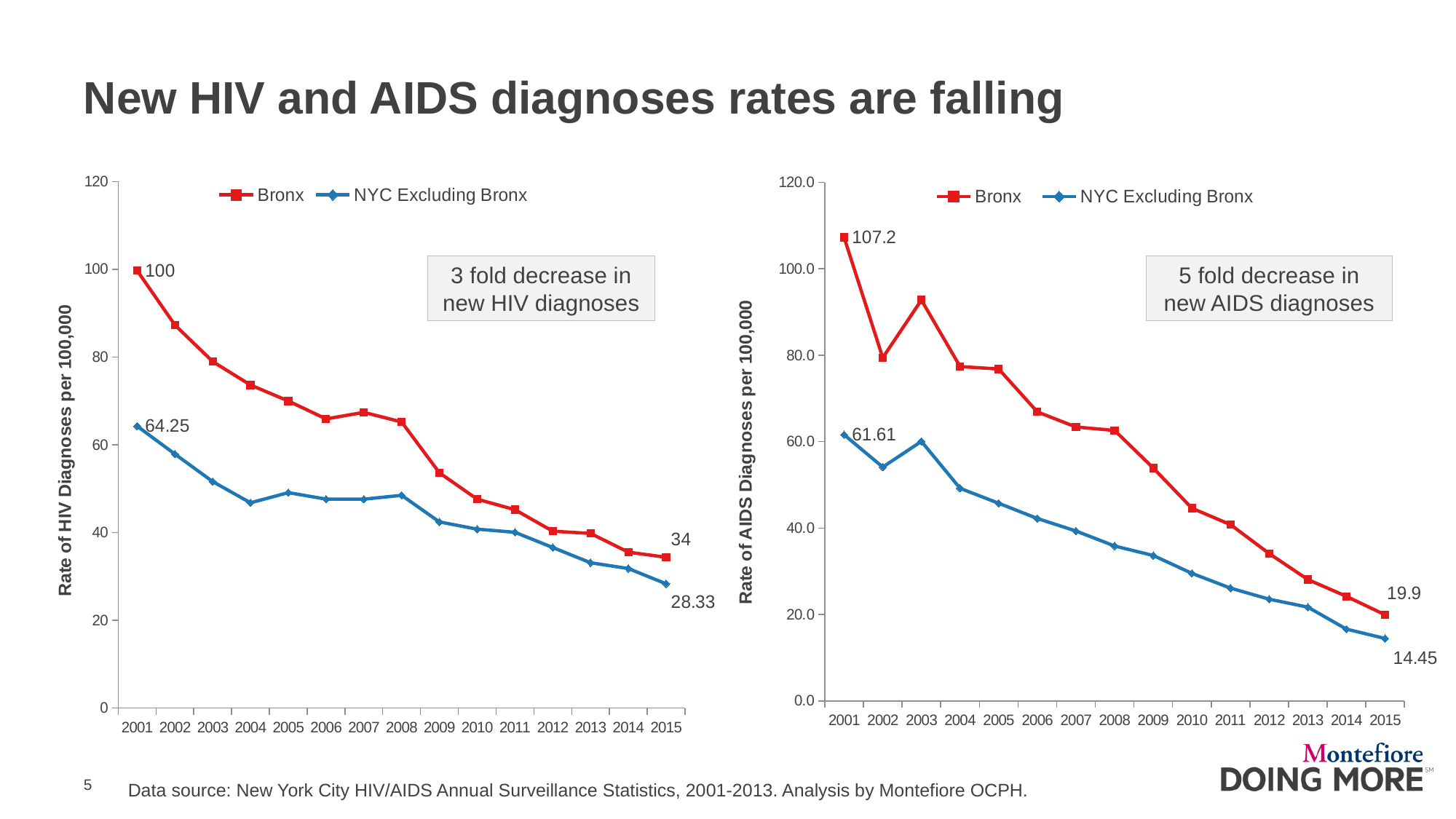
In the left chart (Rate of HIV Diagnoses per 100,000), which series has the higher value in 2001, Bronx or NYC Excluding Bronx? Bronx What kind of chart is the left chart (Rate of HIV Diagnoses per 100,000)? Line chart In the left chart (Rate of HIV Diagnoses per 100,000), is the Bronx value in 2008 greater or less than 60? greater How many years are shown on the x axis of the left chart (Rate of HIV Diagnoses per 100,000)? 15 In the right chart (Rate of AIDS Diagnoses per 100,000), what is the NYC Excluding Bronx value in 2015? 14.45 In the right chart (Rate of AIDS Diagnoses per 100,000), what is the Bronx value in 2001? 107.2 In the left chart (Rate of HIV Diagnoses per 100,000), what is the NYC Excluding Bronx value in 2015? 28.33 In the left chart (Rate of HIV Diagnoses per 100,000), by how much did the Bronx value fall from 2001 to 2015? 66 In the left chart (Rate of HIV Diagnoses per 100,000), what is the Bronx value in 2001? 100 In the right chart (Rate of AIDS Diagnoses per 100,000), by how much did the Bronx value fall from 2001 to 2015? 87.3 How many series does the legend of the right chart (Rate of AIDS Diagnoses per 100,000) list? 2 In the right chart (Rate of AIDS Diagnoses per 100,000), is the NYC Excluding Bronx value in 2010 greater or less than 40? less